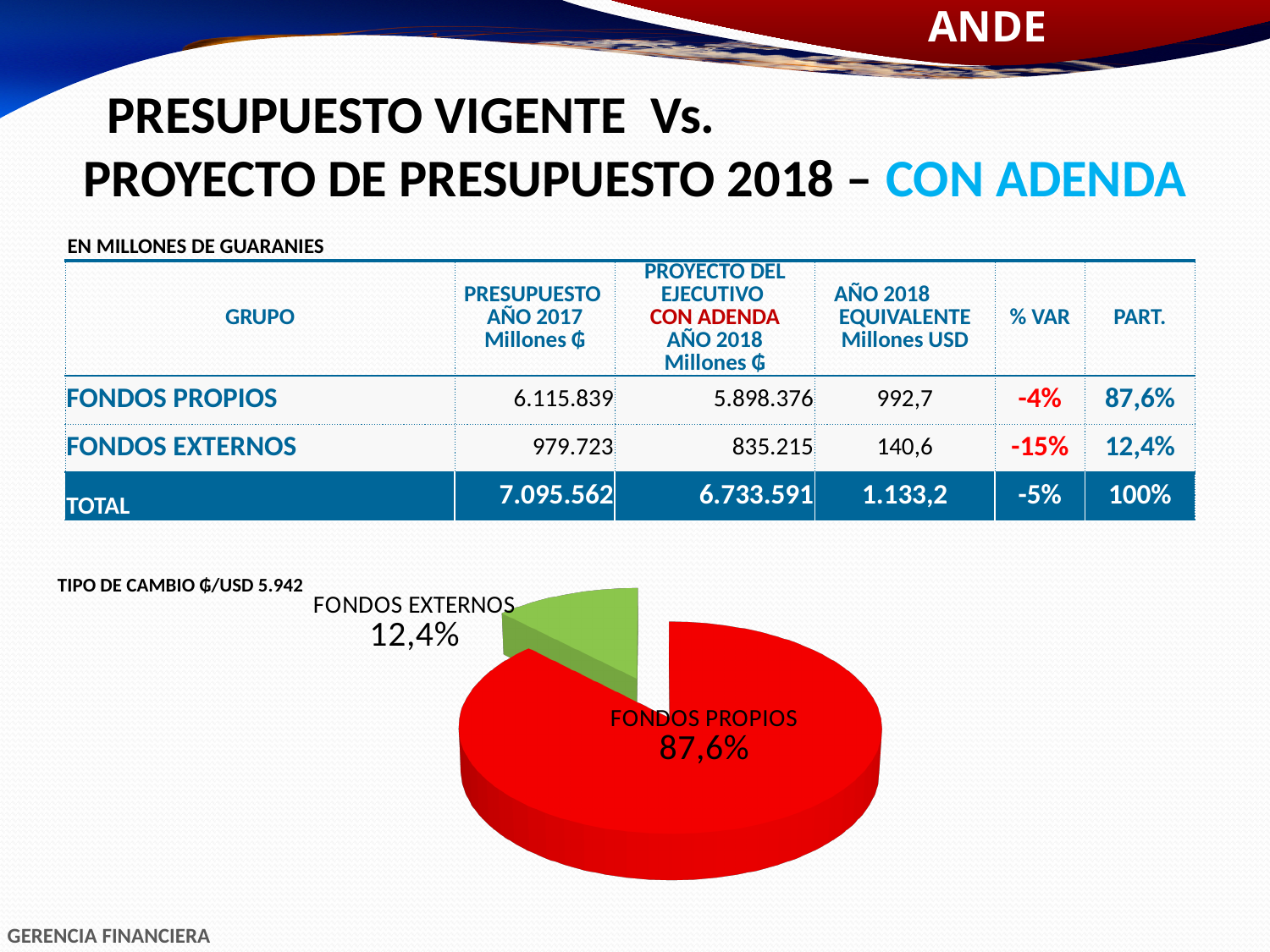
Which slice of the pie chart is the largest? FONDOS PROPIOS What colour is the FONDOS EXTERNOS slice in the pie chart? green What is the difference in percentage points between the FONDOS PROPIOS and FONDOS EXTERNOS slices? 75,2 What kind of chart is shown on the slide? pie chart What colour is the FONDOS PROPIOS slice in the pie chart? red What share of the pie does FONDOS EXTERNOS represent? 12,4% How many slices does the pie chart have? 2 What share of the pie does FONDOS PROPIOS represent? 87,6% Which slice of the pie chart is the smallest? FONDOS EXTERNOS Which is larger in the pie chart, FONDOS PROPIOS or FONDOS EXTERNOS? FONDOS PROPIOS